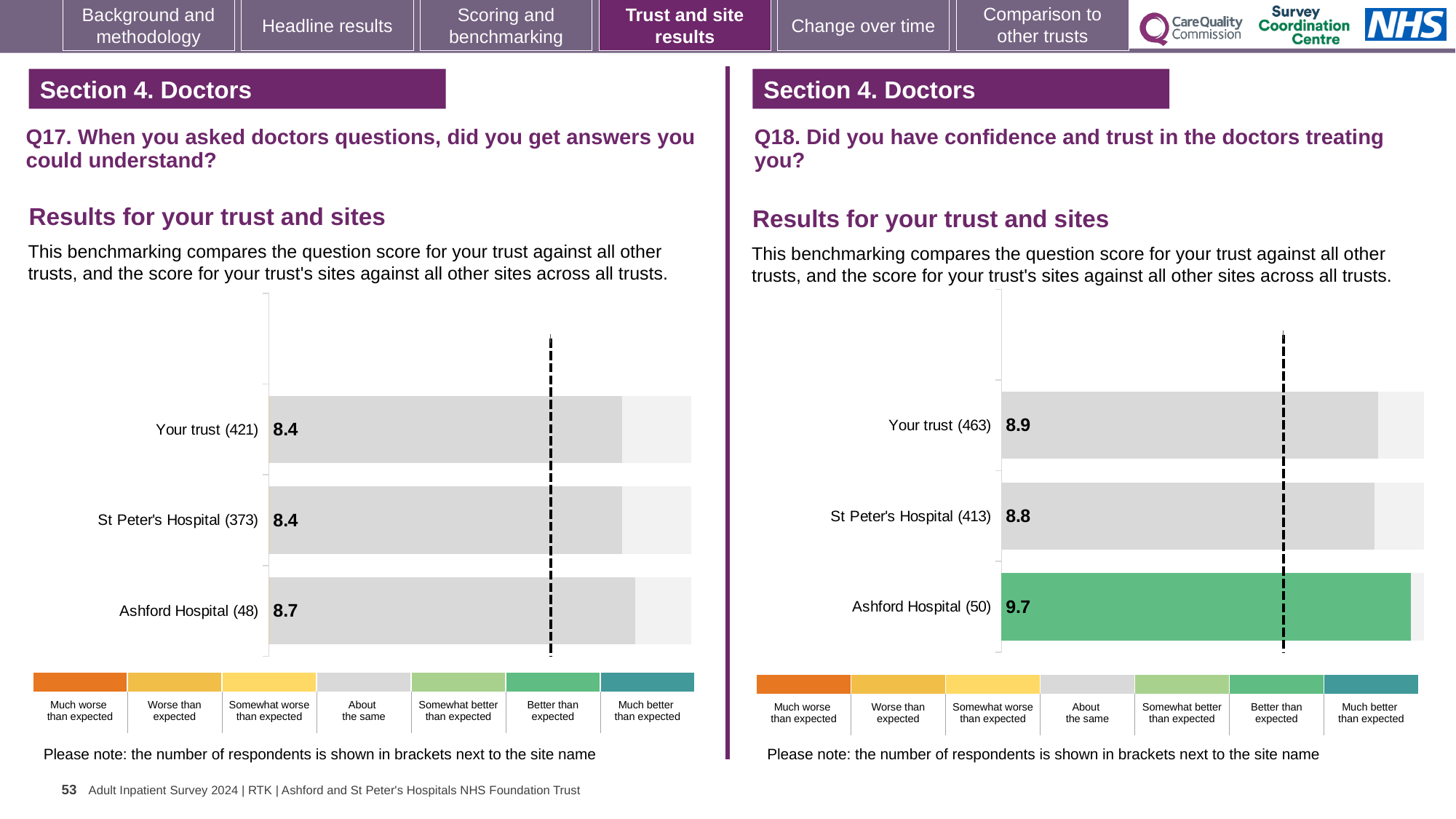
What kind of chart is used on the Q17 chart (left)? Bar chart On the Q18 chart (right), which has the larger score, Your trust or St Peter's Hospital? Your trust On the Q18 chart (right), what is the score for Ashford Hospital? 9.7 On the Q17 chart (left), which site or trust has the highest score? Ashford Hospital How many bars are plotted on the Q18 chart (right)? 3 On the Q17 chart (left), what is the difference between the scores for Ashford Hospital and St Peter's Hospital? 0.3 On the Q17 chart (left), what is the score for Ashford Hospital? 8.7 On the Q18 chart (right), which site or trust has the lowest score? St Peter's Hospital On the Q18 chart (right), what is the score for St Peter's Hospital? 8.8 On the Q18 chart (right), what is the difference between the scores for Ashford Hospital and Your trust? 0.8 On the Q17 chart (left), how many respondents are shown for St Peter's Hospital? 373 On the Q17 chart (left), what is the score for Your trust? 8.4